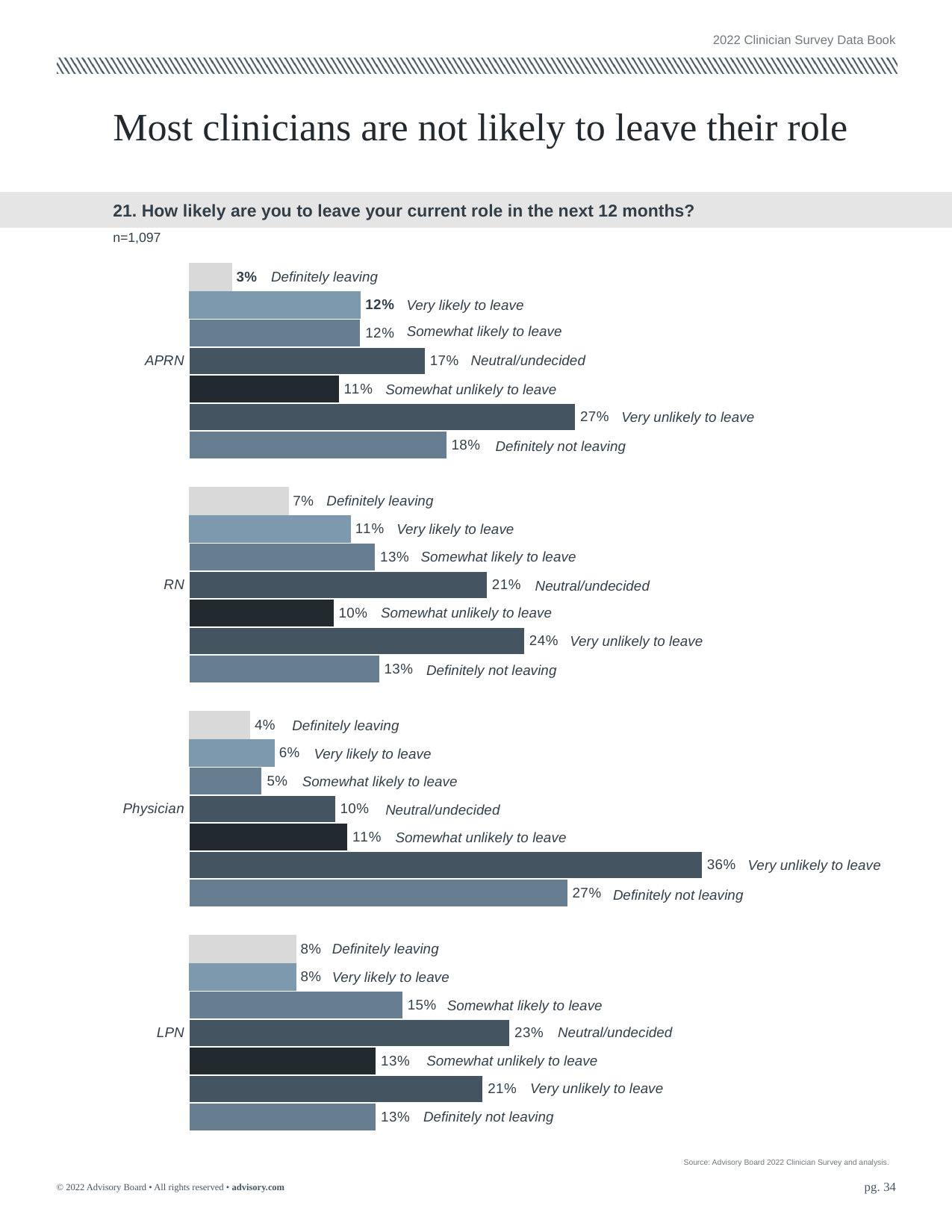
What percentage of APRNs are definitely leaving their current role? 3% Which group has a higher percentage of clinicians definitely leaving, RN or LPN? LPN Which response category has the lowest percentage among physicians? Definitely leaving What is the sample size (n) shown for the survey question? n=1,097 What percentage of RNs are definitely not leaving their role? 13% How many clinician groups are shown in the chart? 4 What type of chart is shown on the slide? Bar chart Which response category has the highest percentage among RNs? Very unlikely to leave How many response categories are shown for each clinician group? 7 What is the difference between the percentage of physicians very unlikely to leave and the percentage of LPNs very unlikely to leave? 15% What percentage of physicians are very unlikely to leave their current role? 36% What percentage of LPNs are neutral/undecided about leaving their role? 23%